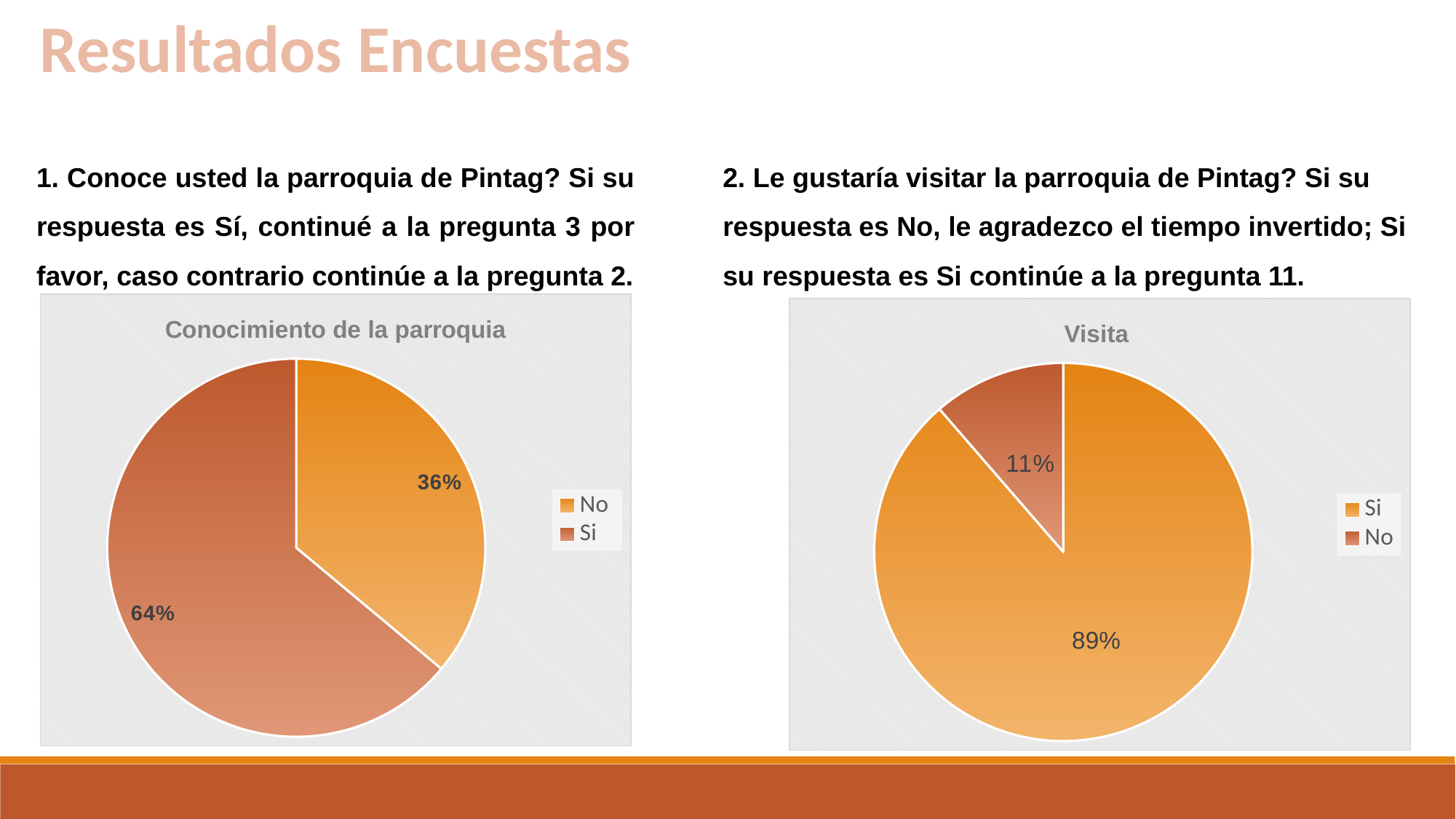
In the 'Visita' chart, what is the difference between the 'Si' and 'No' shares? 78% In the 'Visita' chart, what share of the pie is labelled 'Si'? 89% In the 'Conocimiento de la parroquia' chart, what is the difference between the 'Si' and 'No' shares? 28% What is the title of the chart on the left side of the slide? Conocimiento de la parroquia In the 'Conocimiento de la parroquia' chart, what share of the pie is labelled 'No'? 36% In the 'Visita' chart, which is larger, 'Si' or 'No'? Si In the 'Visita' chart, what share of the pie is labelled 'No'? 11% In the 'Conocimiento de la parroquia' chart, which slice is the largest? Si How many slices does the 'Conocimiento de la parroquia' chart have? 2 What kind of chart is the 'Visita' chart? Pie chart In the 'Visita' chart, which slice is the smallest? No